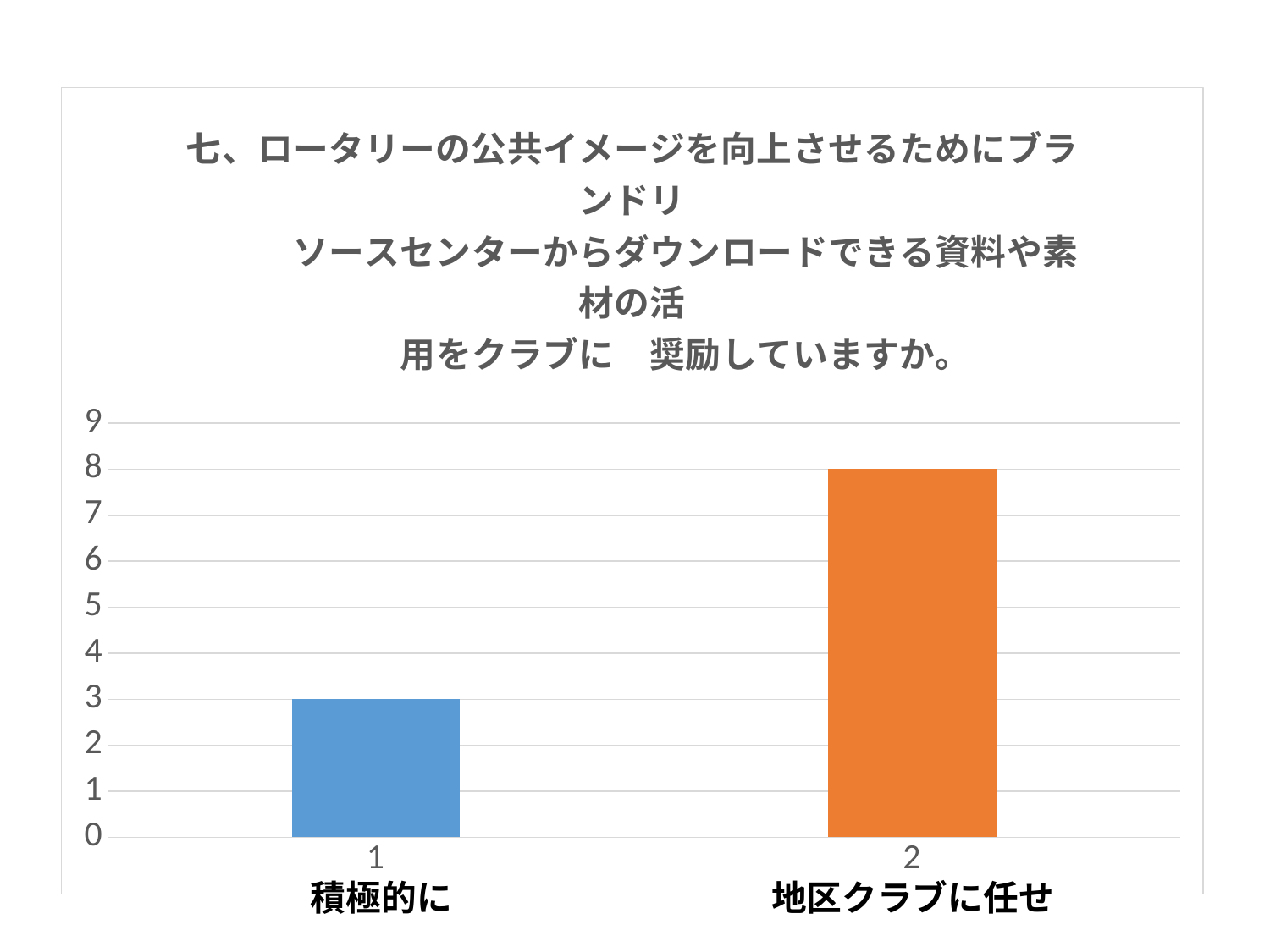
What colour is the bar for 地区クラブに任せ? orange What kind of chart is shown on the slide? bar chart What is the difference between the values for 地区クラブに任せ and 積極的に? 5 What is the value for category 2 (地区クラブに任せ)? 8 Which category has the highest value? 地区クラブに任せ How many categories are shown in the chart? 2 Is the value for 積極的に greater or less than 4? less Which is larger, the value for 積極的に or the value for 地区クラブに任せ? 地区クラブに任せ Is the value for 地区クラブに任せ greater or less than 5? greater What is the maximum value shown on the vertical axis? 9 What is the value for category 1 (積極的に)? 3 Which category has the lowest value? 積極的に